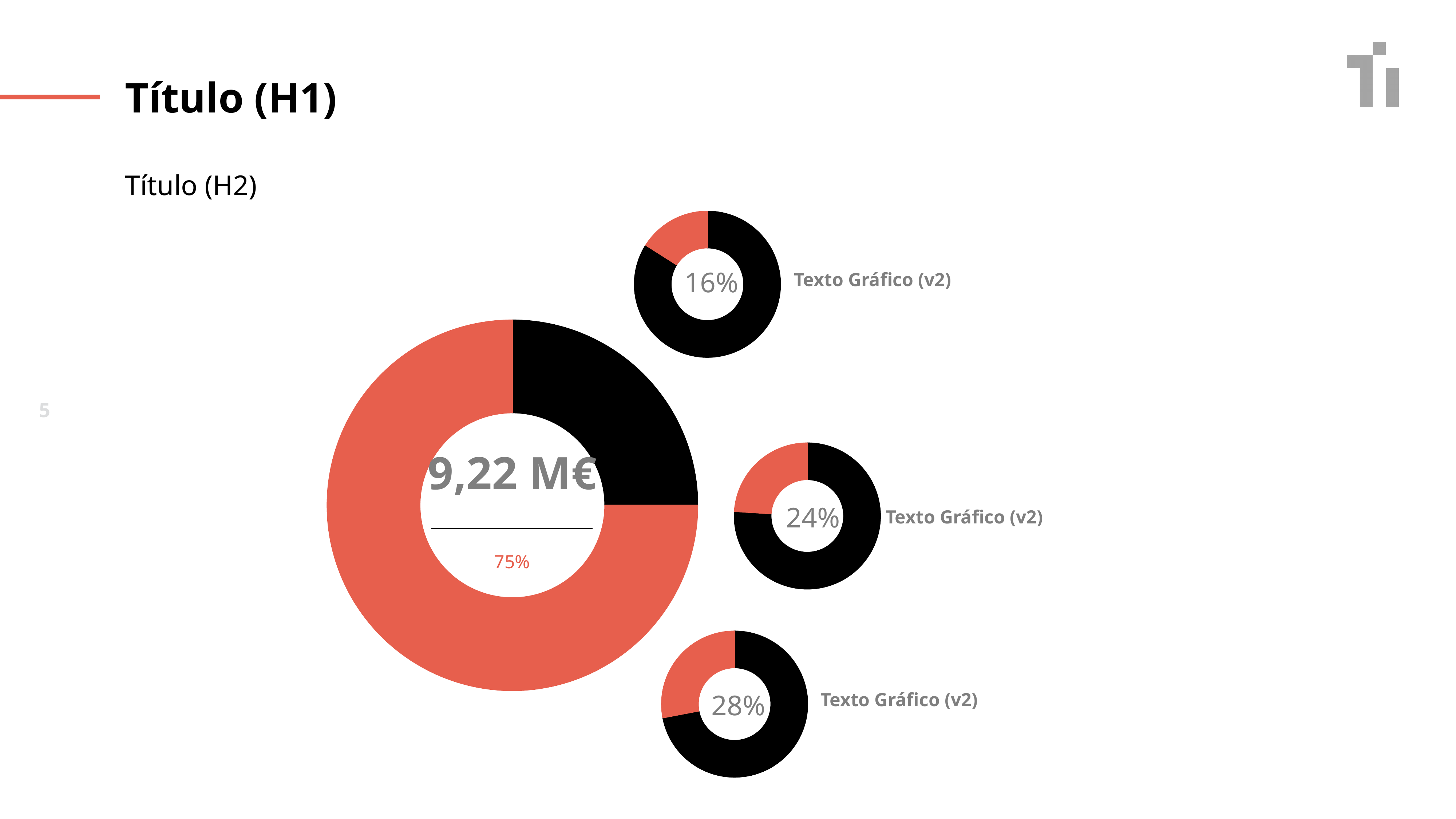
In the large donut chart, which colour segment is larger, the red one or the black one? red What label text appears to the right of each small donut chart? Texto Gráfico (v2) Which of the three small donut charts shows the lowest percentage? the top one (16%) What kind of chart is the large chart in the centre of the slide? donut chart How many donut charts are on the slide in total? 4 What percentage is printed below the line inside the large donut chart? 75% What percentage is shown in the centre of the middle small donut chart? 24% What value is printed in the centre of the large donut chart? 9,22 M€ What percentage is shown in the centre of the top small donut chart? 16% Which of the three small donut charts shows the highest percentage? the bottom one (28%) What is the difference between the percentage in the bottom small donut chart and the percentage in the top small donut chart? 12% What percentage is shown in the centre of the bottom small donut chart? 28%